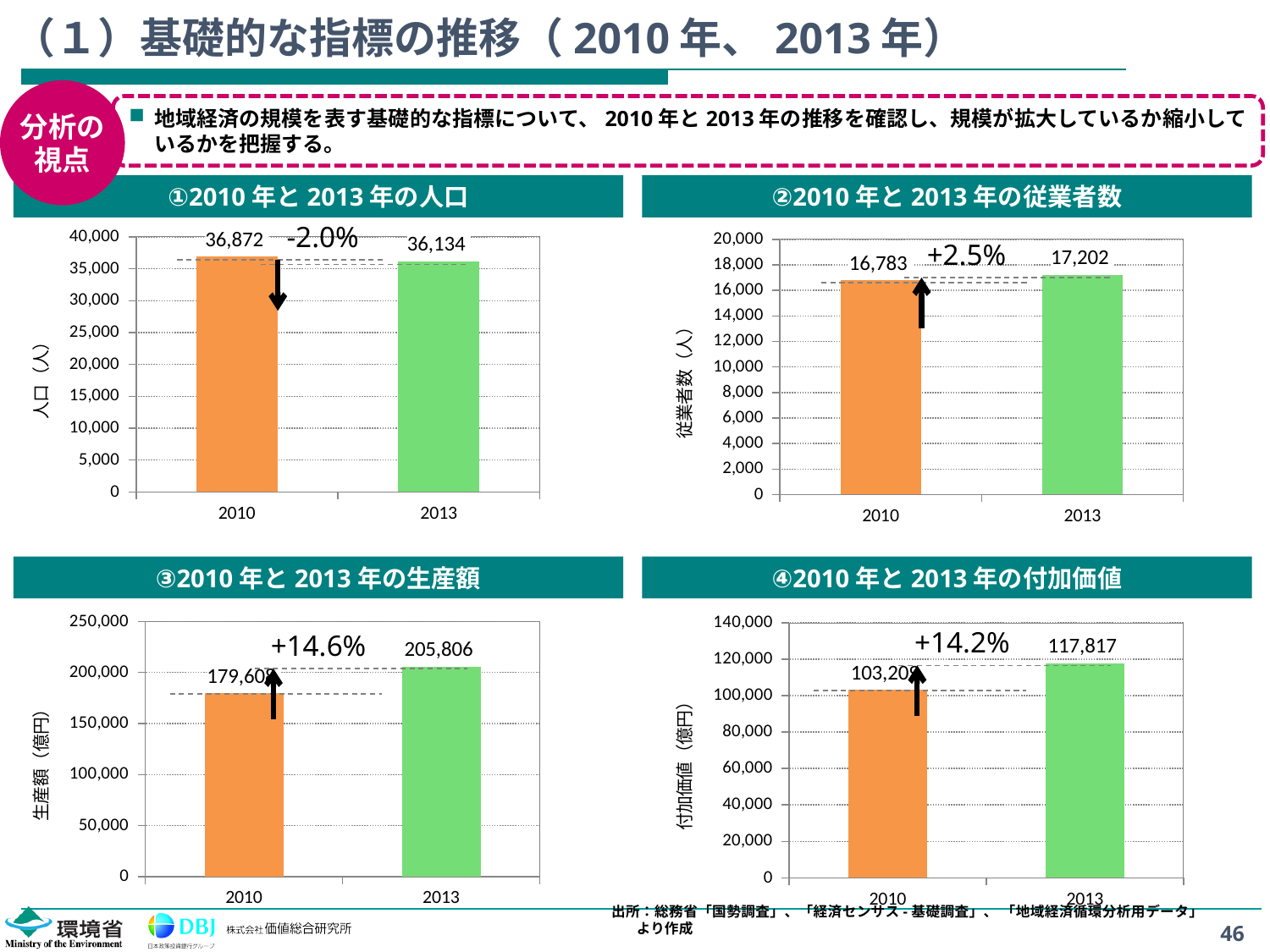
In the chart ③2010年と2013年の生産額, what is the value for 2013? 205,806 In the chart ②2010年と2013年の従業者数, what is the value for 2013? 17,202 In the chart ③2010年と2013年の生産額, is the value for 2010 greater or less than 200,000? less In the chart ④2010年と2013年の付加価値, do the values rise or fall from 2010 to 2013? rise What kind of chart is ④2010年と2013年の付加価値? bar chart In the chart ②2010年と2013年の従業者数, what is the value for 2010? 16,783 In the chart ①2010年と2013年の人口, what is the difference between the 2010 and 2013 values? 738 In the chart ①2010年と2013年の人口, what is the population value for 2013? 36,134 In the chart ②2010年と2013年の従業者数, which year has the higher value? 2013 In the chart ①2010年と2013年の人口, what percentage change is annotated between 2010 and 2013? -2.0% In the chart ①2010年と2013年の人口, what is the population value for 2010? 36,872 In the chart ④2010年と2013年の付加価値, what is the value for 2013? 117,817